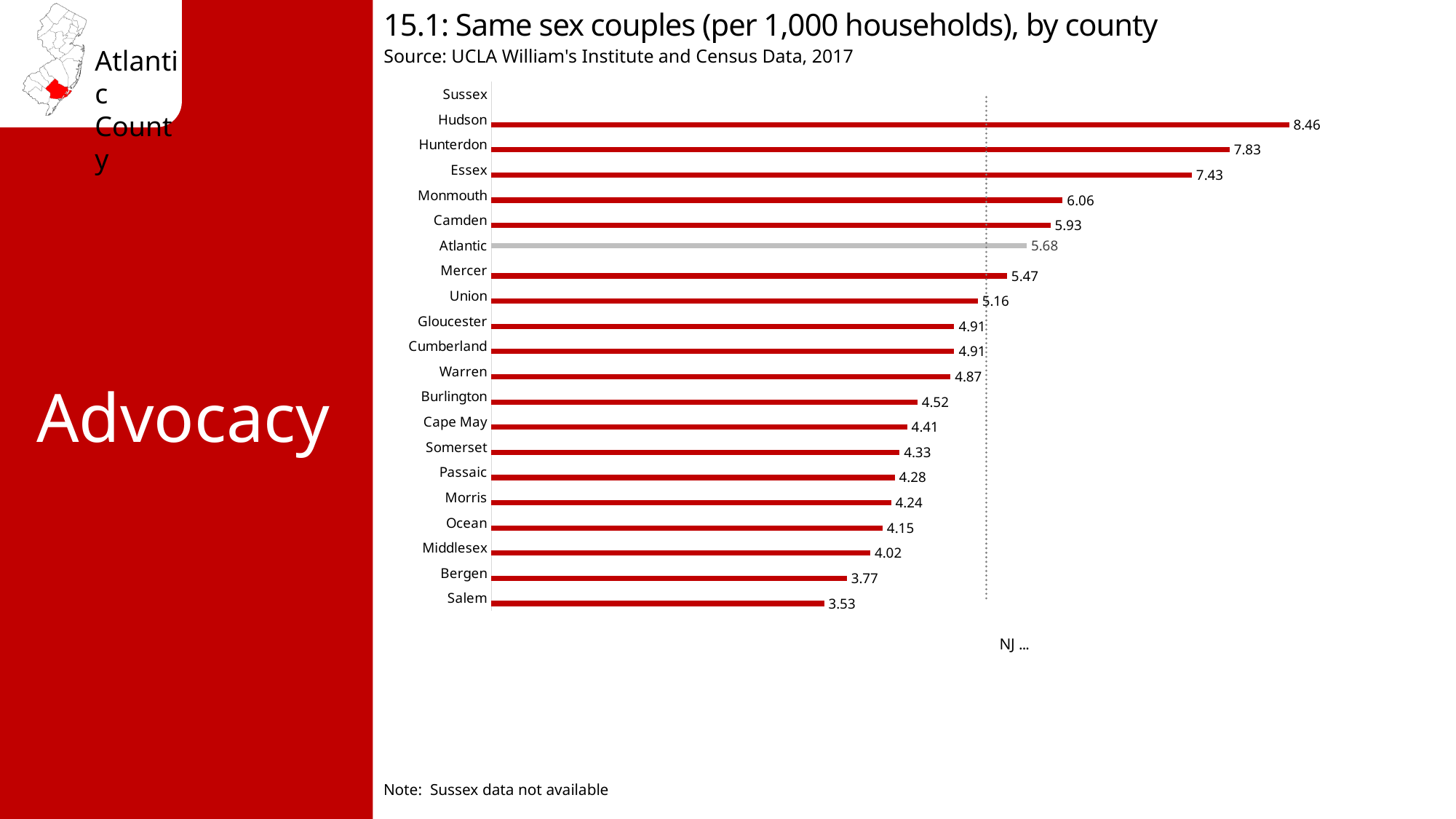
Which county with a plotted bar has the lowest value? Salem What is the value for Atlantic County? 5.68 According to the note, which county's data is not available? Sussex Which county's bar is coloured grey instead of red? Atlantic What is the value for Cape May? 4.41 What is the value for Hudson County? 8.46 How many counties are listed on the vertical axis? 21 Which has a larger value, Monmouth or Mercer? Monmouth What kind of chart is shown? Bar chart Which county has the highest value? Hudson What is the difference between the values for Atlantic and Camden? 0.25 What is the difference between the values for Hudson and Salem? 4.93